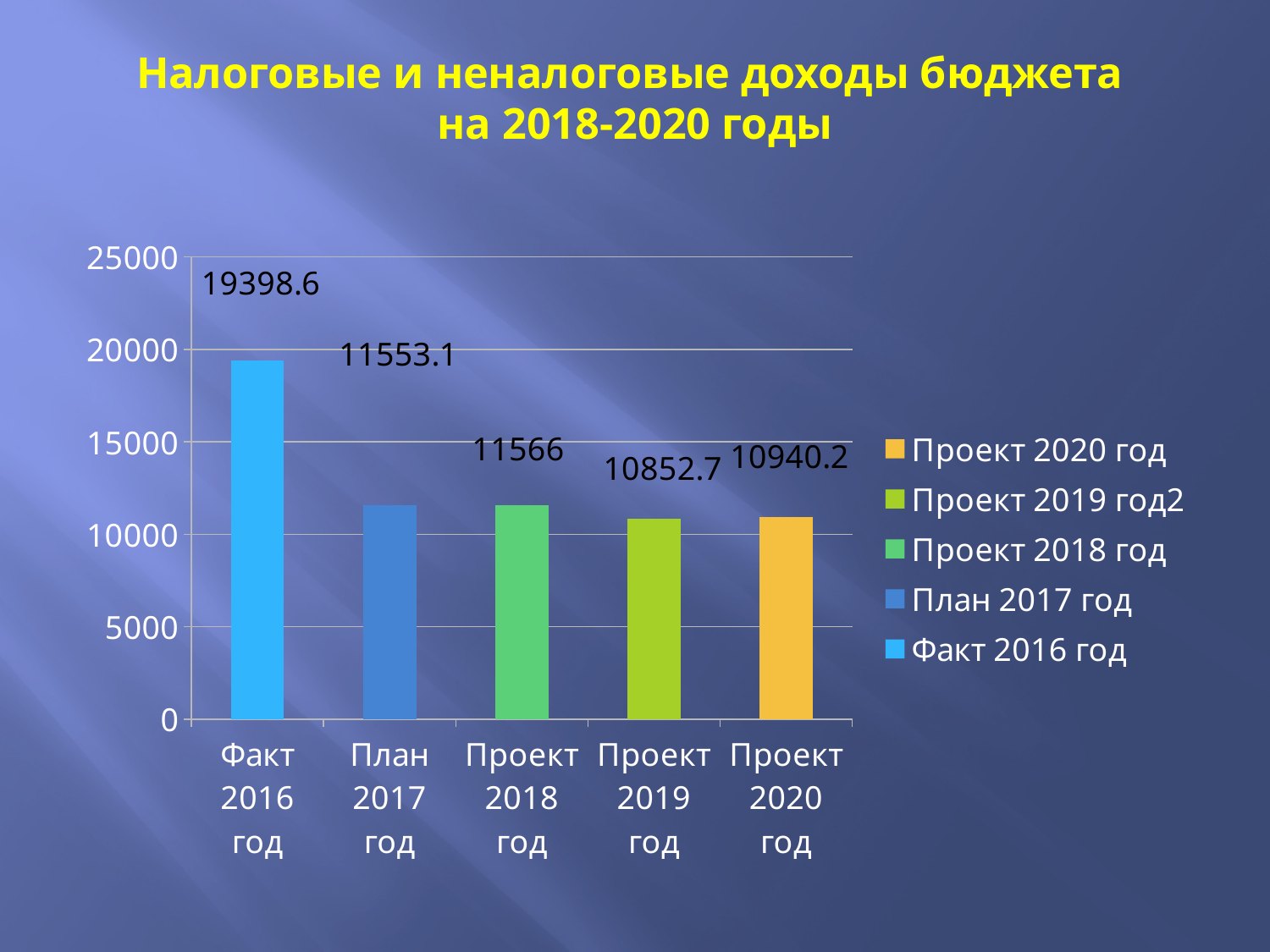
What is the value for Проект 2018 год? 11566 Which is larger, the value for Факт 2016 год or the value for Проект 2020 год? Факт 2016 год Which category has the highest value? Факт 2016 год What kind of chart is shown on the slide? Bar chart What is the value for Проект 2020 год? 10940.2 How many entries does the legend list? 5 How many bars are shown in the chart? 5 What is the value for Проект 2019 год? 10852.7 What is the value for Факт 2016 год? 19398.6 What is the difference between the values for Факт 2016 год and План 2017 год? 7845.5 Which category has the lowest value? Проект 2019 год What is the value for План 2017 год? 11553.1